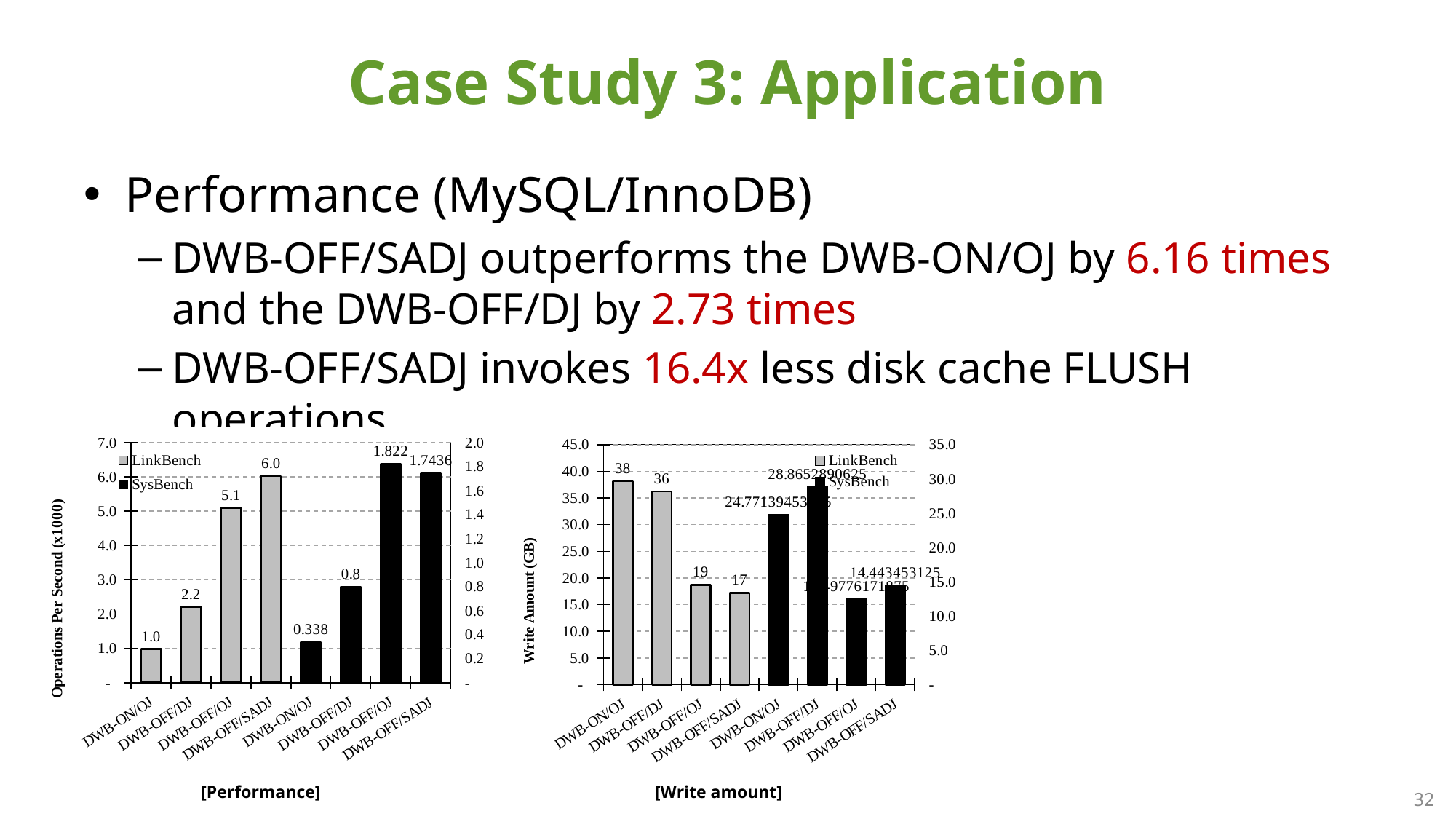
What kind of chart is the Write amount chart? Bar chart In the Performance chart, what is the SysBench value for DWB-ON/OJ? 0.338 In the Performance chart, which configuration has the highest LinkBench value? DWB-OFF/SADJ In the Performance chart, what is the LinkBench value for DWB-OFF/SADJ? 6.0 How many series does the legend of the Performance chart list? 2 What is the y-axis title of the Write amount chart? Write Amount (GB) In the Write amount chart, what is the LinkBench value for DWB-ON/OJ? 38 In the Performance chart, which SysBench value is larger: DWB-OFF/OJ or DWB-OFF/SADJ? DWB-OFF/OJ In the Write amount chart, what is the SysBench value for DWB-OFF/SADJ? 14.443453125 In the Write amount chart, what is the difference between the LinkBench values for DWB-ON/OJ and DWB-OFF/DJ? 2 In the Performance chart, what is the difference between the LinkBench values for DWB-OFF/OJ and DWB-OFF/DJ? 2.9 In the Write amount chart, which configuration has the lowest LinkBench write amount? DWB-OFF/SADJ